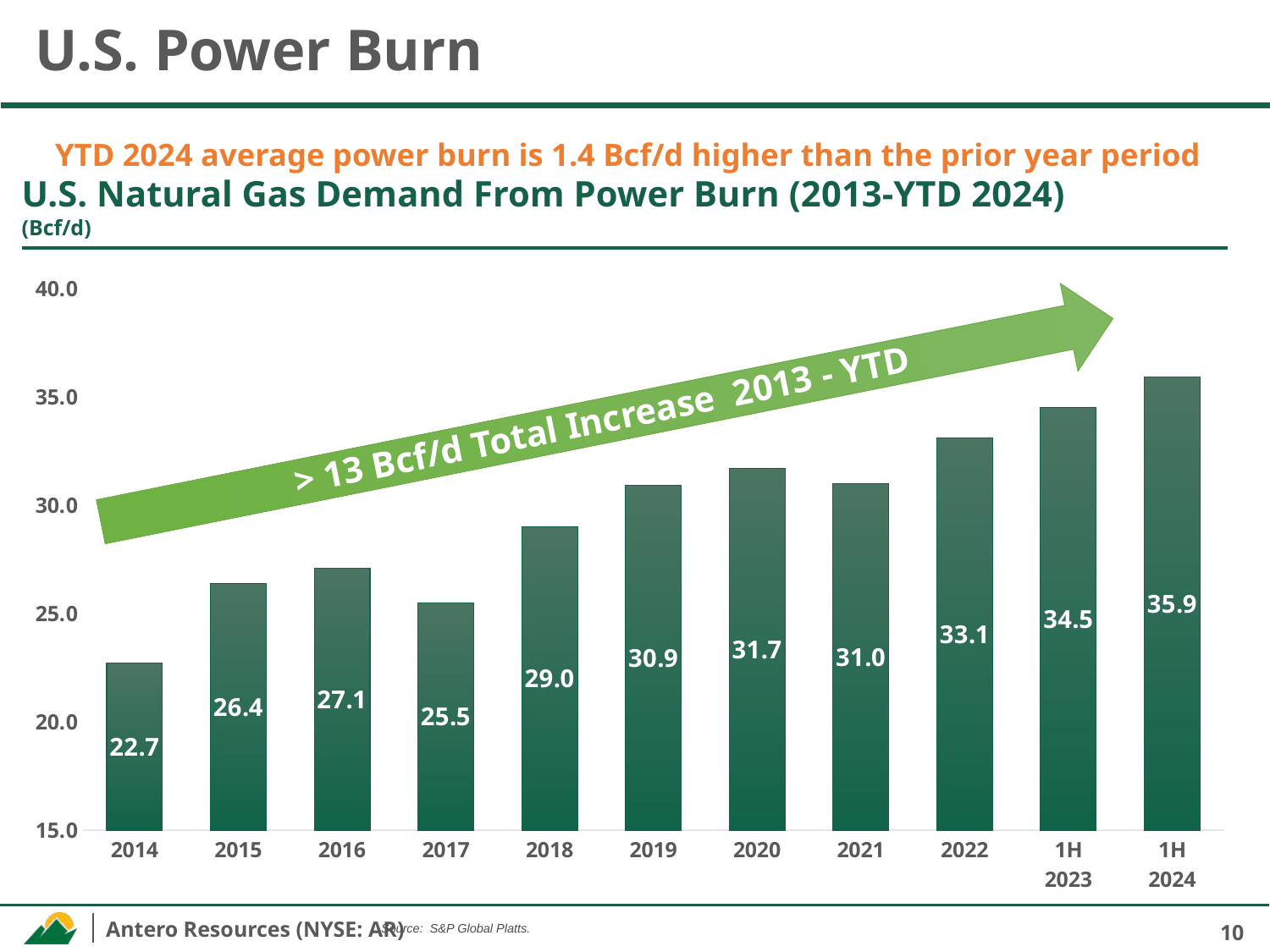
Is the value for 2019 greater or less than 30.0? greater Which is larger, the value for 2017 or the value for 2016? 2016 What is the difference between the 1H 2024 and 1H 2023 values? 1.4 What unit is shown for the chart's values? Bcf/d What is the difference between the 2022 and 2014 values? 10.4 What is the power burn value for 2018? 29.0 How many bars are shown in the chart? 11 What is the power burn value for 2021? 31.0 What kind of chart is shown on the slide? Bar chart Which category has the lowest power burn value? 2014 Which category has the highest power burn value? 1H 2024 What is the power burn value for 1H 2024? 35.9